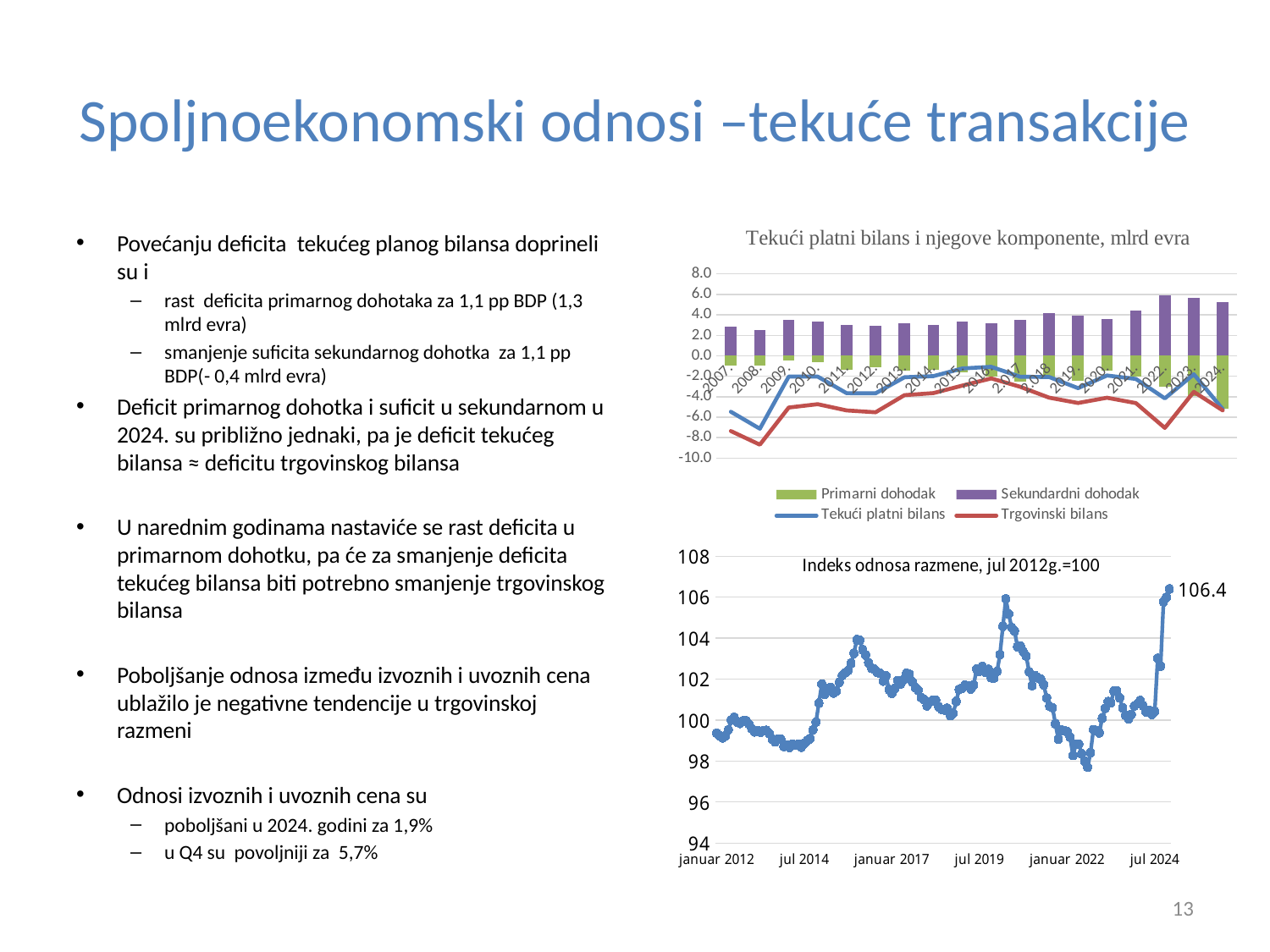
On the chart 'Tekući platni bilans i njegove komponente, mlrd evra', how many series does the legend list? 4 On the chart 'Indeks odnosa razmene, jul 2012g.=100', what is the value shown by the data label at the end of the series? 106.4 On the chart 'Tekući platni bilans i njegove komponente, mlrd evra', is the Trgovinski bilans value for 2008 greater or less than -6.0? less What is the title of the lower chart on the slide? Indeks odnosa razmene, jul 2012g.=100 On the chart 'Tekući platni bilans i njegove komponente, mlrd evra', what colour represents Primarni dohodak? green On the chart 'Tekući platni bilans i njegove komponente, mlrd evra', which year has the lowest Trgovinski bilans value? 2008. On the chart 'Indeks odnosa razmene, jul 2012g.=100', is the value at januar 2012 greater or less than 100? less On the chart 'Tekući platni bilans i njegove komponente, mlrd evra', how many years are shown on the x axis? 18 On the chart 'Tekući platni bilans i njegove komponente, mlrd evra', is the Tekući platni bilans value for 2016 greater or less than -4.0? greater On the chart 'Indeks odnosa razmene, jul 2012g.=100', does the index end higher or lower than it starts? higher On the chart 'Tekući platni bilans i njegove komponente, mlrd evra', which series are listed in the legend? Primarni dohodak, Sekundardni dohodak, Tekući platni bilans, Trgovinski bilans